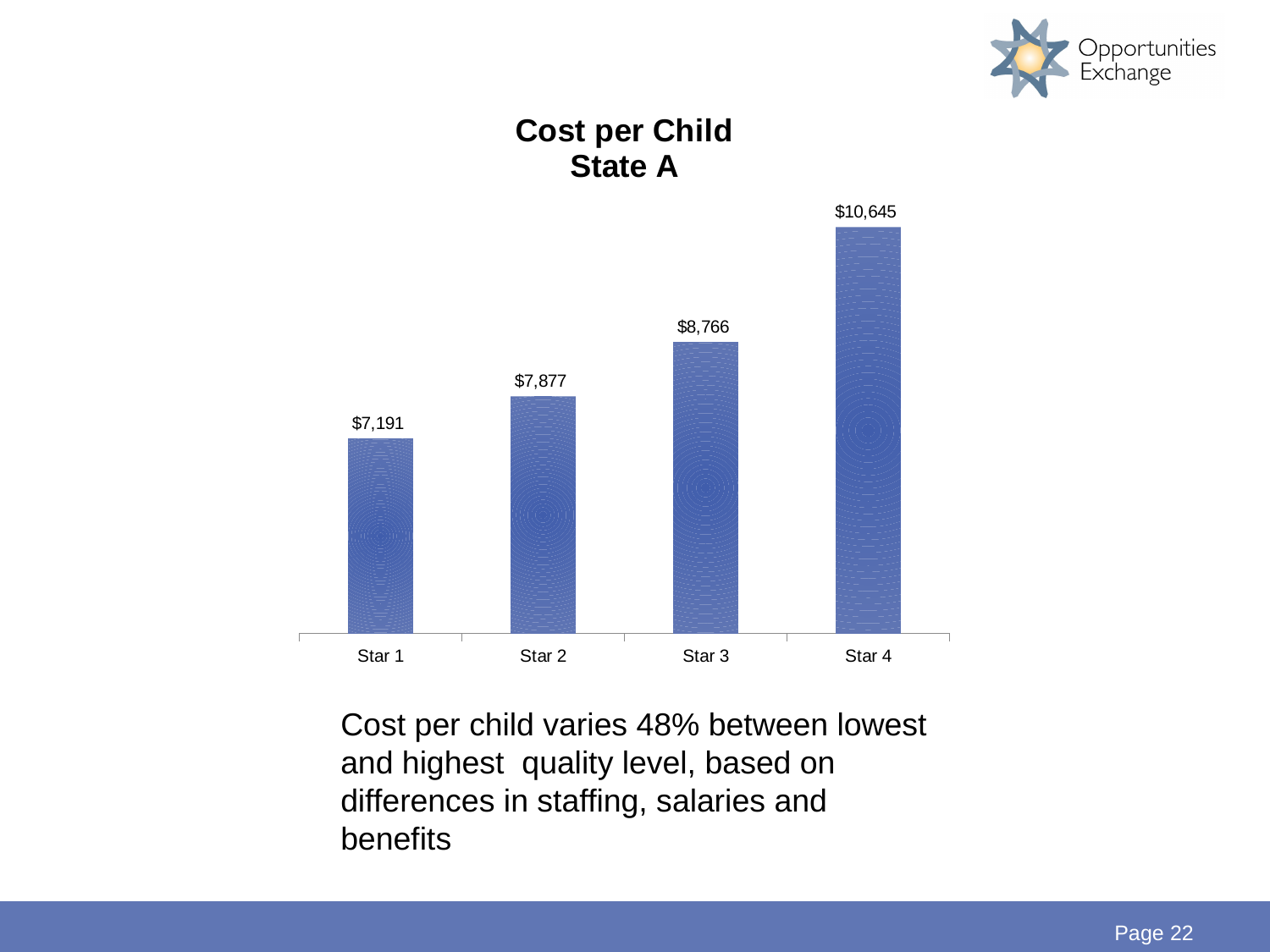
How many star levels are shown in the chart? 4 What is the difference in cost per child between Star 3 and Star 2? $889 What is the difference in cost per child between Star 4 and Star 1? $3,454 What kind of chart is shown on the slide? Bar chart Which star level has the lowest cost per child? Star 1 What is the cost per child for Star 2? $7,877 What is the cost per child for Star 1? $7,191 What is the cost per child for Star 3? $8,766 What is the cost per child for Star 4? $10,645 Which has a higher cost per child, Star 2 or Star 3? Star 3 Which star level has the highest cost per child? Star 4 Do the cost per child values rise or fall from Star 1 to Star 4? Rise